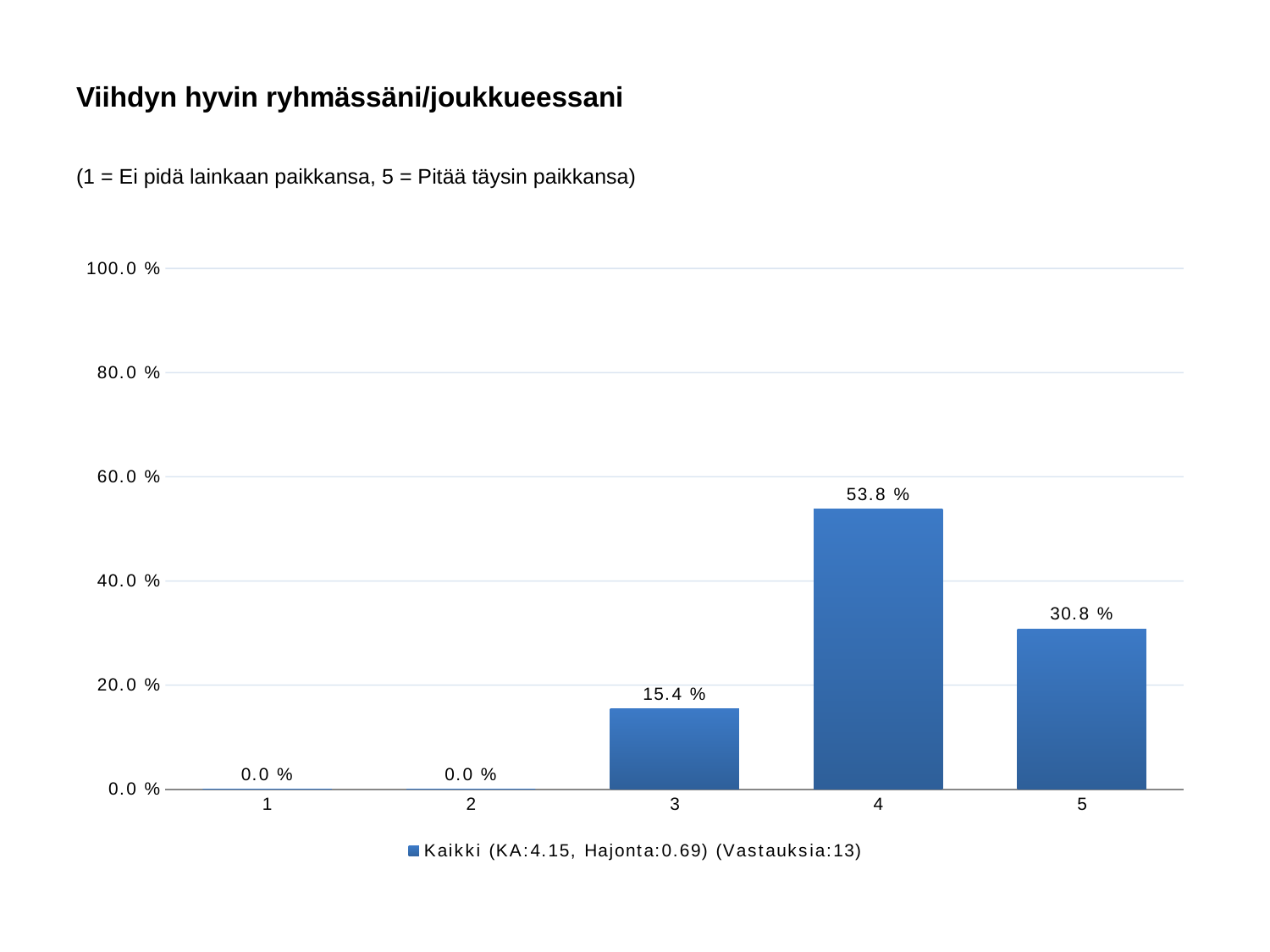
Is the value for category 4 greater or less than 40.0 %? greater Which category has the highest value? 4 What is the value for category 1? 0.0 % What is the value for category 3? 15.4 % What is the value for category 4? 53.8 % How many categories are shown on the x axis? 5 What is the difference between the values for categories 4 and 5? 23.0 % How many series does the legend list? 1 What is the value for category 5? 30.8 % What is the title of the slide? Viihdyn hyvin ryhmässäni/joukkueessani What kind of chart is shown on the slide? bar chart Which is larger, the value for category 3 or the value for category 5? 5